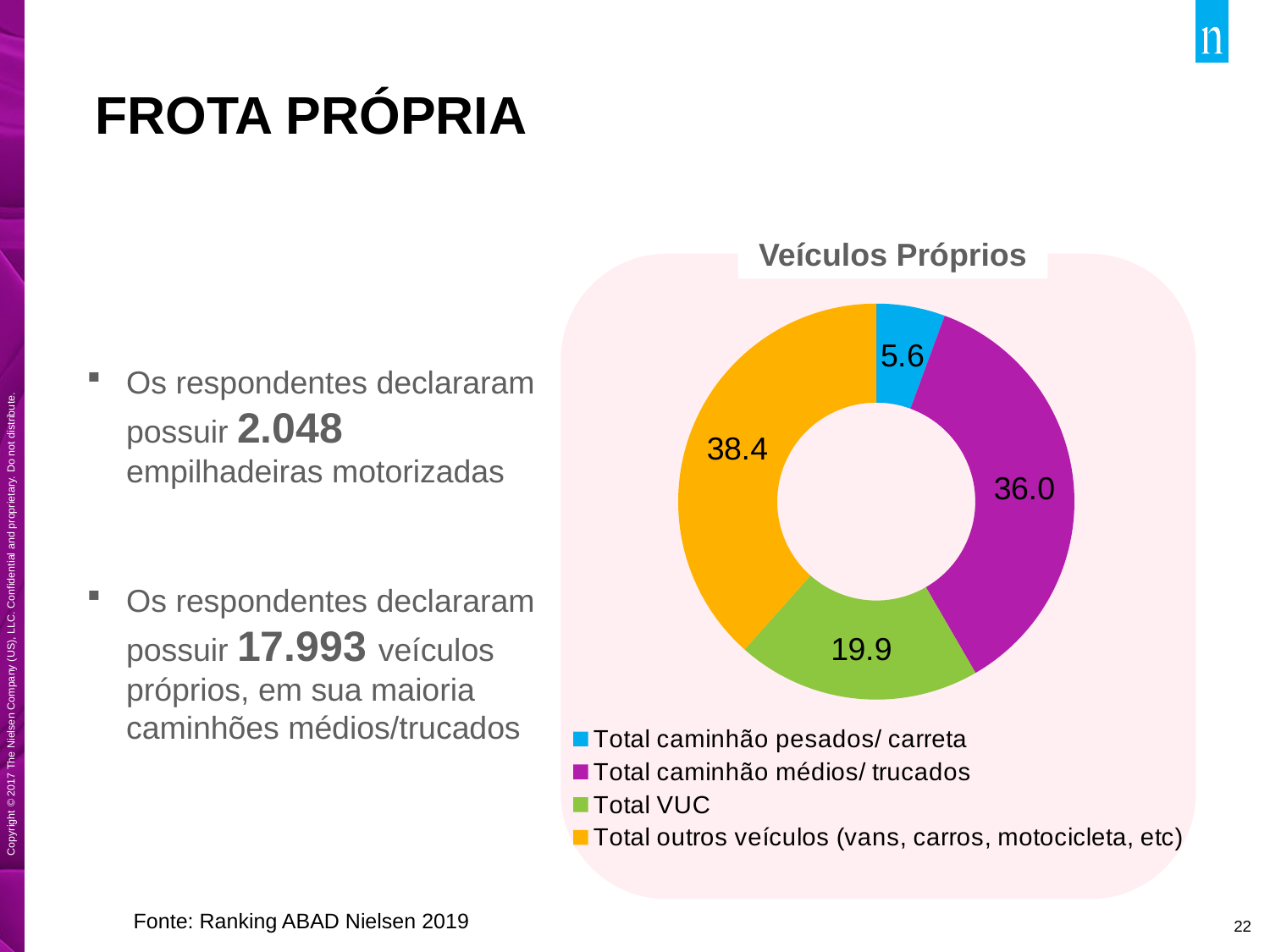
Which is larger in the Veículos Próprios chart: Total VUC or Total caminhão pesados/ carreta? Total VUC What is the value for Total caminhão médios/ trucados in the Veículos Próprios chart? 36.0 What colour is the Total VUC slice in the Veículos Próprios chart? Green What is the value for Total caminhão pesados/ carreta in the Veículos Próprios chart? 5.6 What is the value for Total outros veículos (vans, carros, motocicleta, etc) in the Veículos Próprios chart? 38.4 Which category has the smallest slice in the Veículos Próprios chart? Total caminhão pesados/ carreta How many categories are shown in the Veículos Próprios chart? 4 What is the difference between the values for Total caminhão médios/ trucados and Total VUC in the Veículos Próprios chart? 16.1 What is the value for Total VUC in the Veículos Próprios chart? 19.9 What is the title of the chart on the slide? Veículos Próprios What kind of chart is the Veículos Próprios chart? Doughnut chart Which category has the largest slice in the Veículos Próprios chart? Total outros veículos (vans, carros, motocicleta, etc)